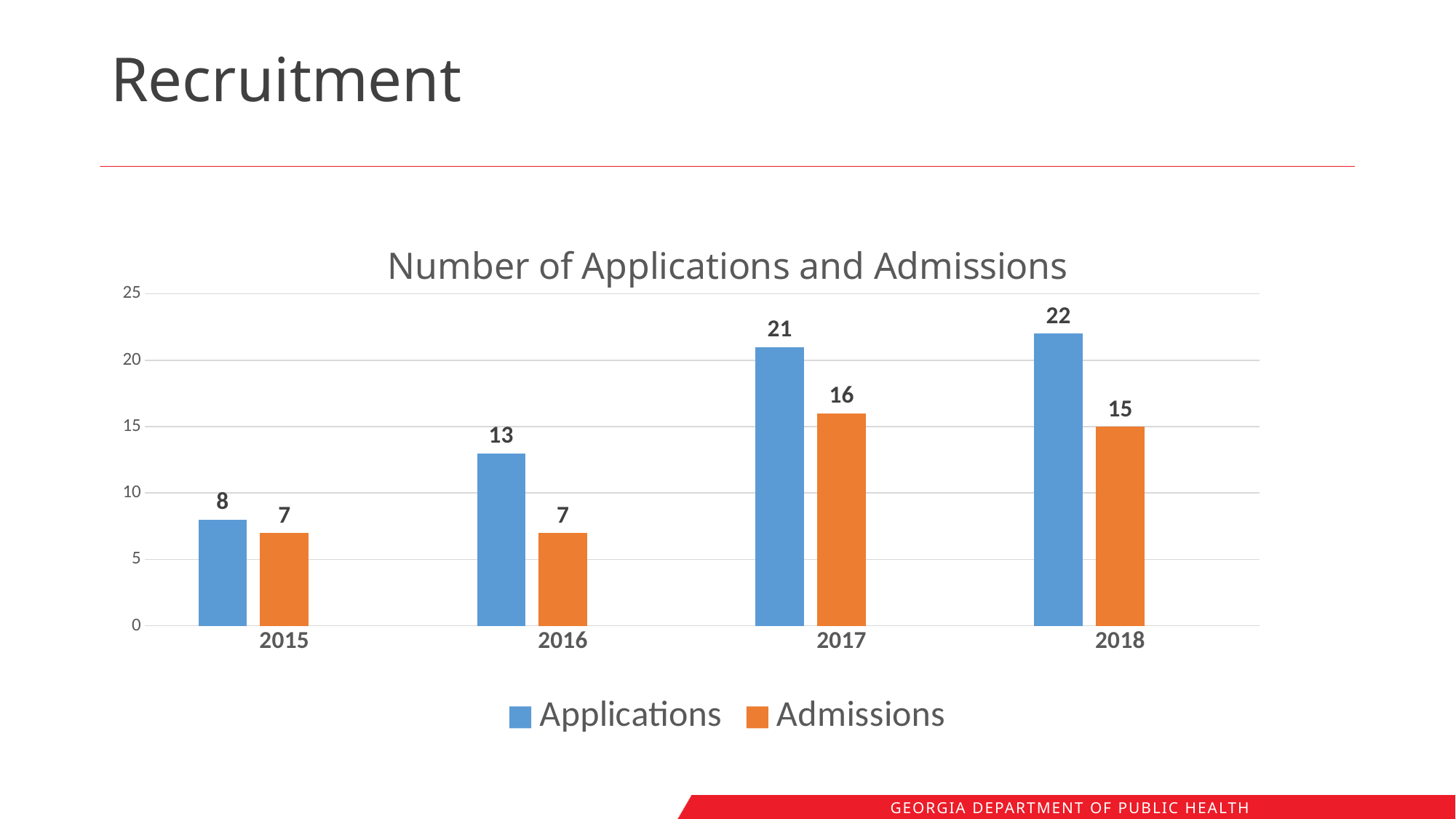
What kind of chart is shown on the slide? Bar chart How many years are shown on the x axis? 4 Which is larger, Admissions in 2017 or Admissions in 2018? Admissions in 2017 How many series does the legend list? 2 What is the title of the chart? Number of Applications and Admissions What is the difference between Applications and Admissions in 2016? 6 What is the number of Applications in 2017? 21 What is the number of Admissions in 2015? 7 What is the number of Admissions in 2018? 15 Which year has the highest number of Applications? 2018 Which year has the lowest number of Applications? 2015 Do the Applications values rise or fall from 2015 to 2018? Rise